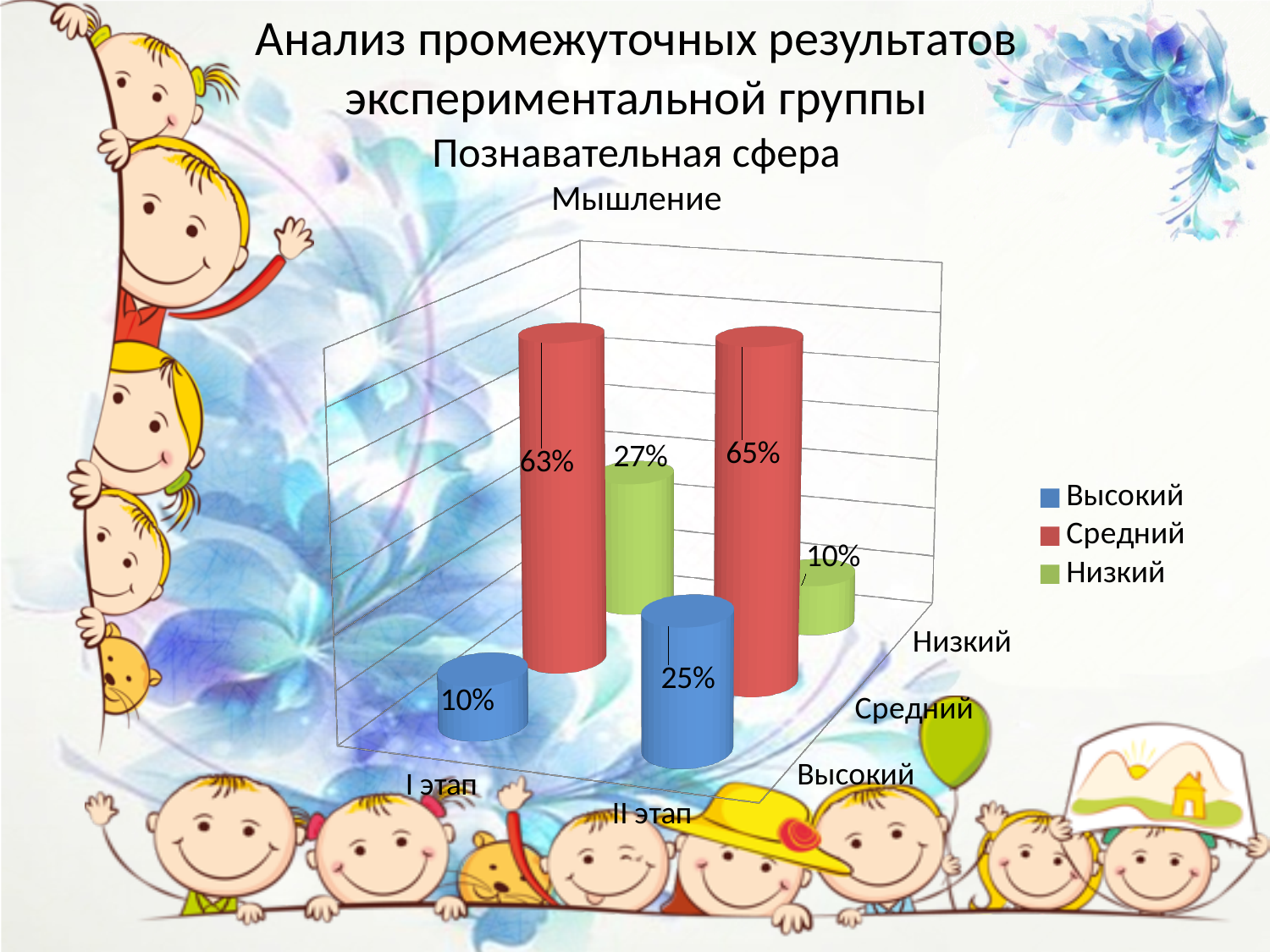
How many series does the legend list? 3 What is the title of the chart? Мышление What is the value for Высокий at II этап? 25% What kind of chart is shown on the slide? Bar chart What is the difference between the Высокий values at II этап and I этап? 15% Which series has the lowest value at I этап? Высокий What is the value for Низкий at II этап? 10% Which is larger: Низкий at I этап or Низкий at II этап? Низкий at I этап Which series has the highest value at II этап? Средний What is the value for Средний at I этап? 63% How many stages (categories) are shown on the x axis? 2 What is the value for Низкий at I этап? 27%